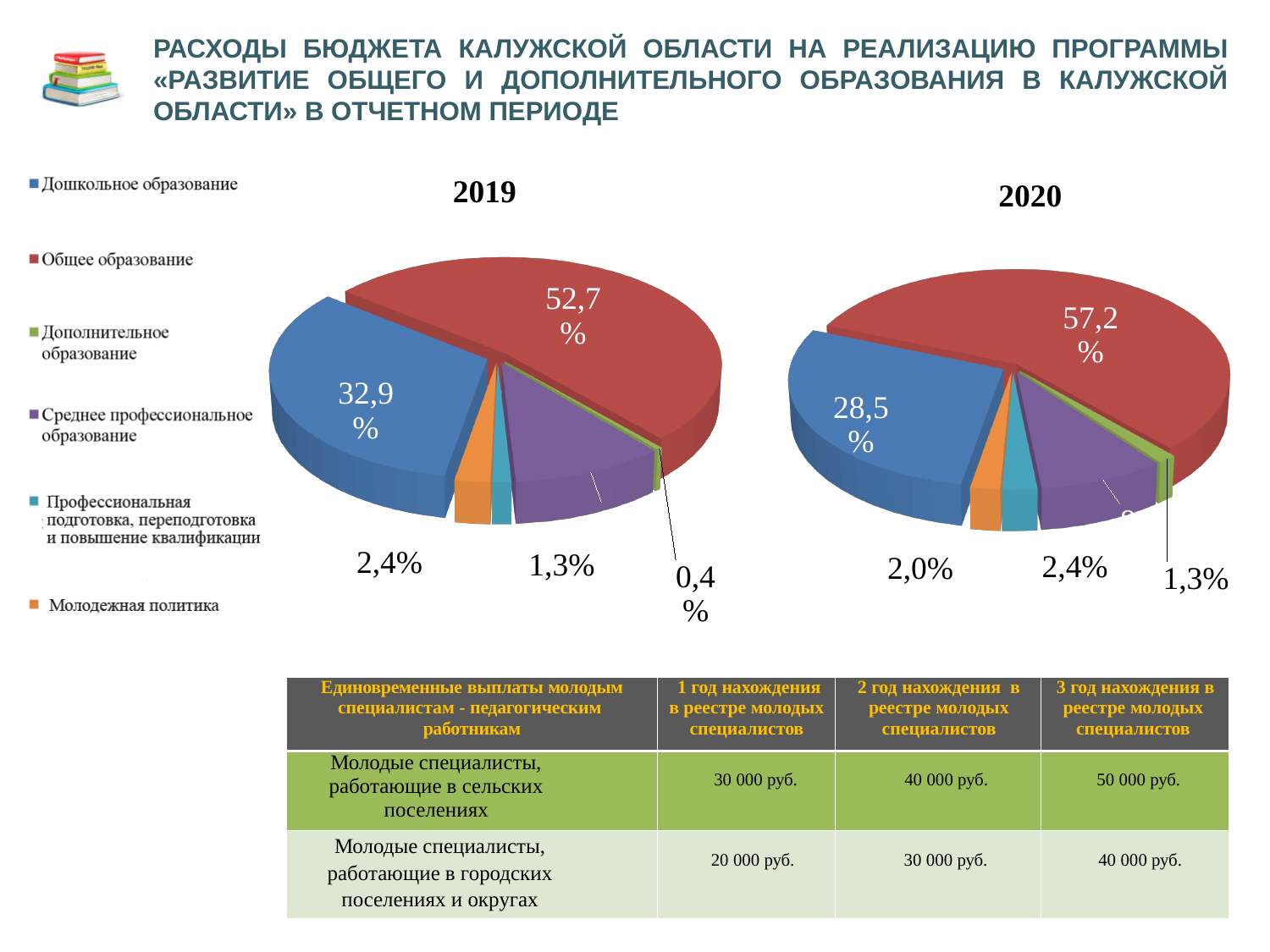
In the 2020 pie chart, which category has the largest slice? Общее образование What type of chart is used to show the 2019 and 2020 budget expenditures? Pie chart How many categories does the legend list for the pie charts? 6 In the 2020 pie chart, what share is shown for Дошкольное образование? 28,5% In the 2020 pie chart, what share is shown for Дополнительное образование? 1,3% In the 2019 pie chart, which category has the largest slice? Общее образование By how many percentage points does the share of Общее образование in the 2020 chart exceed its share in the 2019 chart? 4,5 In the 2019 pie chart, what share is shown for Дошкольное образование? 32,9% In the 2020 pie chart, what share is shown for Общее образование? 57,2% Is the share of Общее образование larger in the 2019 chart or the 2020 chart? 2020 In the 2019 pie chart, what share is shown for Общее образование? 52,7% In the 2019 pie chart, what share is shown for Дополнительное образование? 0,4%